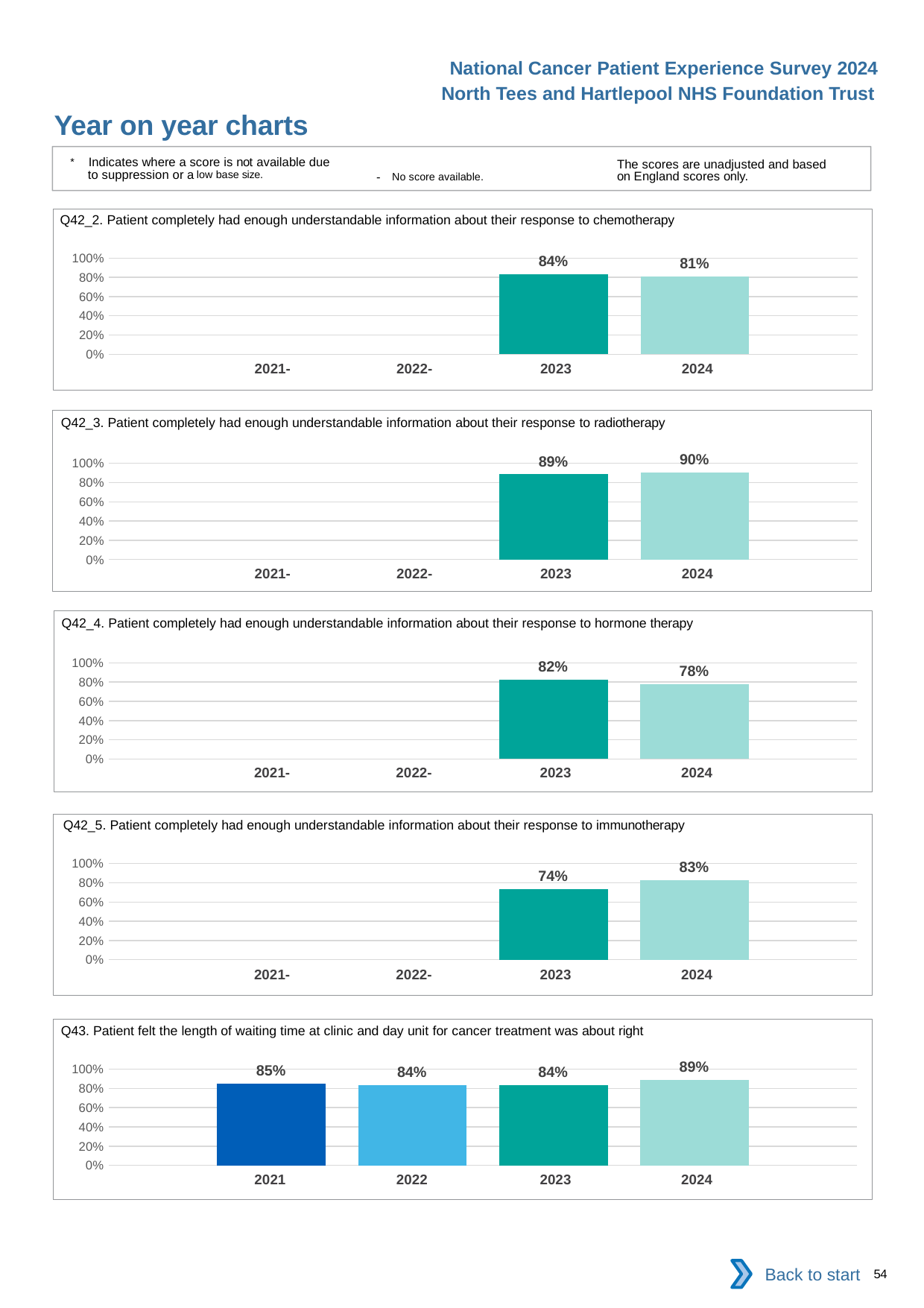
In the Q42_3 chart (radiotherapy), what is the value for 2024? 90% In the Q42_4 chart (hormone therapy), do the values rise or fall from 2023 to 2024? fall In the Q43 chart (waiting time at clinic and day unit), how many years have bars plotted? 4 In the Q43 chart (waiting time at clinic and day unit), what is the value for 2021? 85% What type of chart is the Q43 chart at the bottom of the slide? bar chart In the Q42_4 chart (hormone therapy), what is the value for 2024? 78% In the Q42_5 chart (immunotherapy), what is the value for 2023? 74% In the Q42_2 chart (chemotherapy), what is the value for 2023? 84% In the Q42_3 chart (radiotherapy), which year has the higher value, 2023 or 2024? 2024 In the Q43 chart (waiting time at clinic and day unit), which year has the highest value? 2024 In the Q42_5 chart (immunotherapy), what is the difference between the 2024 and 2023 values? 9% In the Q42_2 chart (chemotherapy), what is the difference between the 2023 and 2024 values? 3%